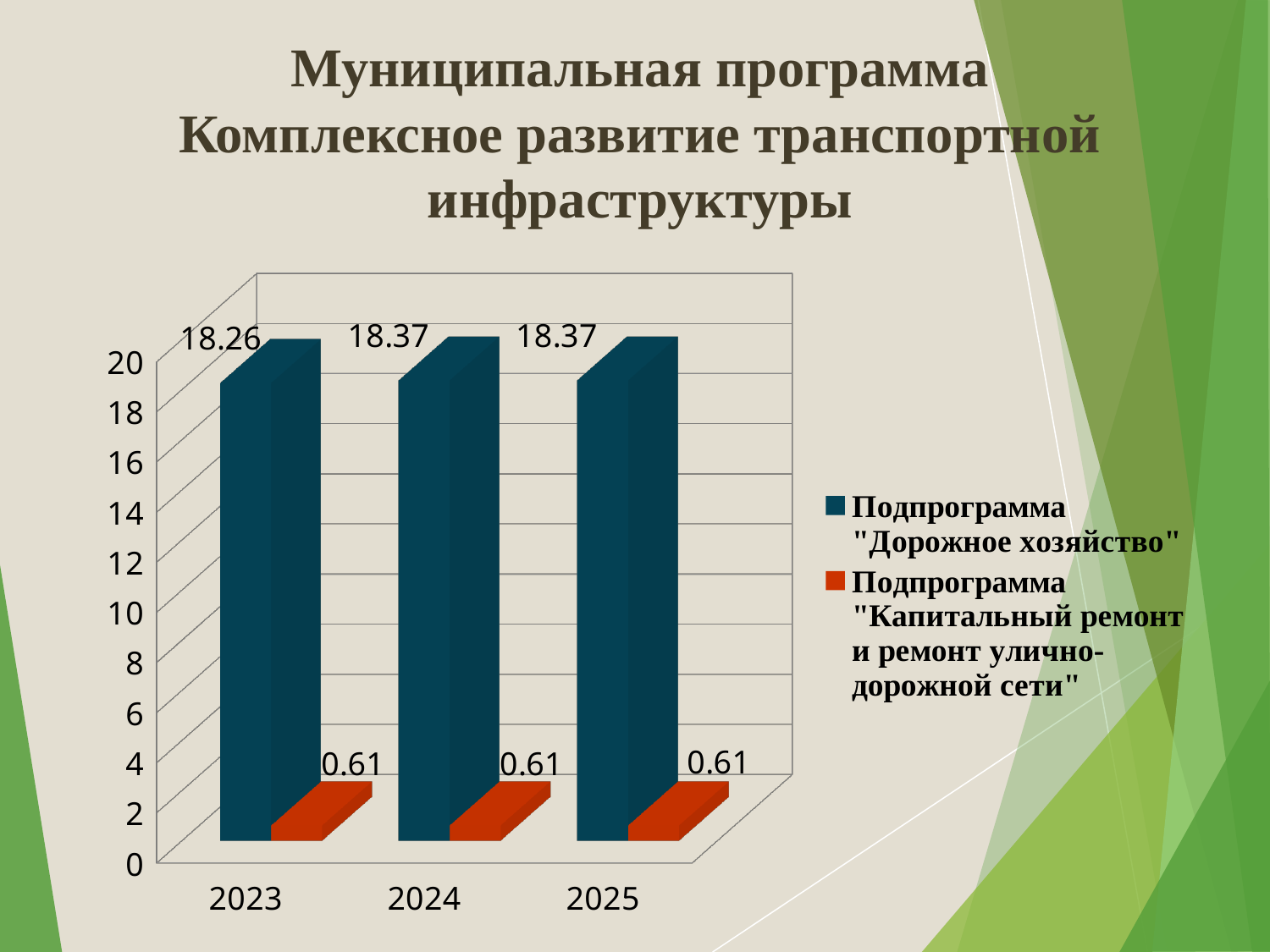
What is the difference between the two subprogrammes' values in 2024? 17.76 What kind of chart is shown on the slide? bar chart How many years are shown on the x axis? 3 What is the value for Подпрограмма "Капитальный ремонт и ремонт улично-дорожной сети" in 2025? 0.61 What is the value for Подпрограмма "Дорожное хозяйство" in 2024? 18.37 Which year has the lowest value for Подпрограмма "Дорожное хозяйство"? 2023 How many series does the legend list? 2 Is the value for Подпрограмма "Дорожное хозяйство" in 2025 greater or less than 16? greater What is the value for Подпрограмма "Дорожное хозяйство" in 2023? 18.26 What colour are the bars for Подпрограмма "Капитальный ремонт и ремонт улично-дорожной сети"? red Which subprogramme has the larger value in 2025? Подпрограмма "Дорожное хозяйство" What is the difference between the Подпрограмма "Дорожное хозяйство" values for 2024 and 2023? 0.11